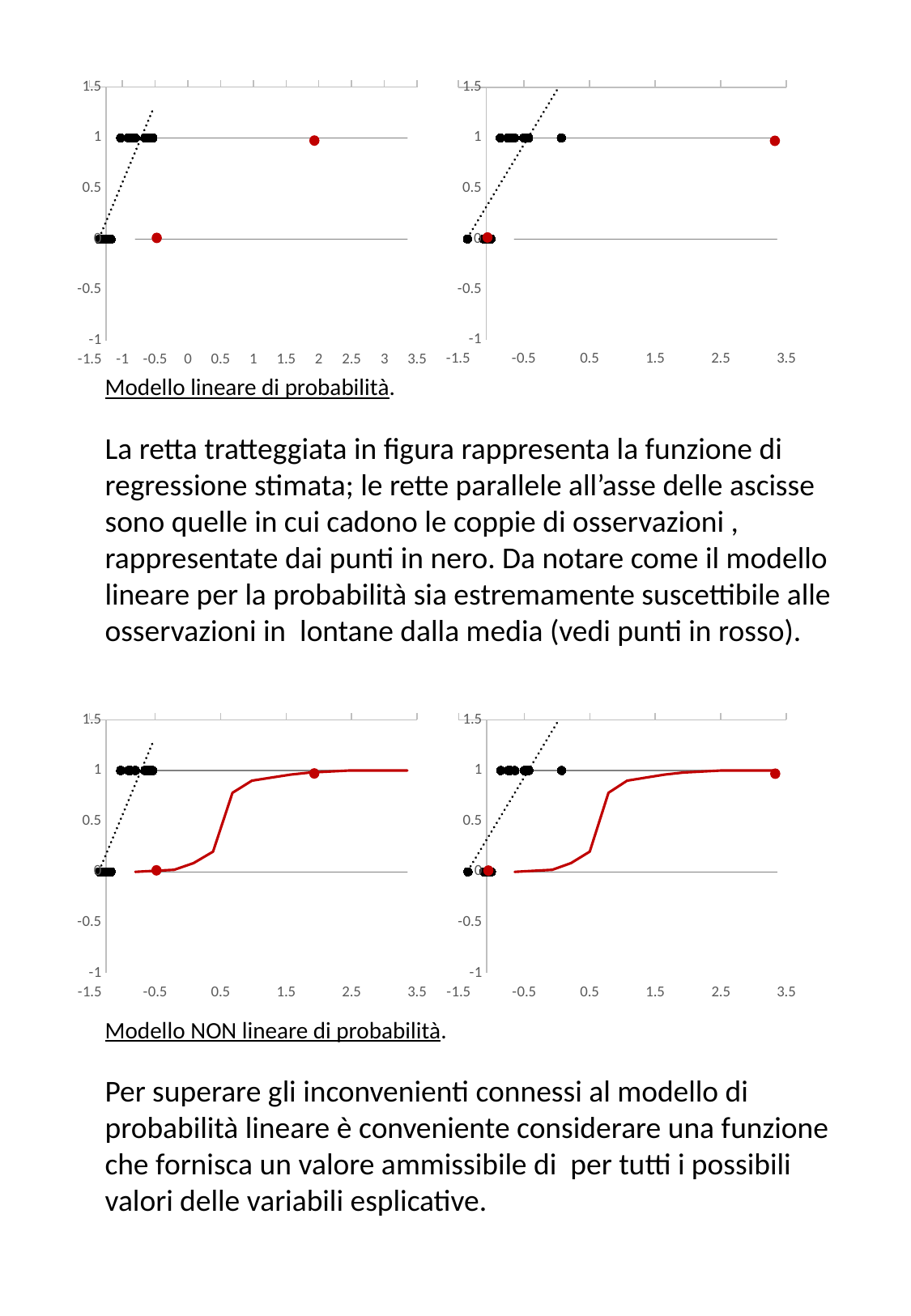
In the top-left chart, is the x value of the rightmost red point greater or less than 2.5? less In the top-left chart, is the y value of the rightmost red point greater or less than 0.5? greater In the top-left chart, is the x value of the rightmost red point greater or less than 1.5? greater In the bottom-left chart, does the red curve rise or fall as x increases? rises What is the highest tick value shown on the y axis of the top-left chart? 1.5 What is the lowest tick value shown on the x axis of the bottom-right chart? -1.5 In the bottom-right chart, does the red curve rise or fall as x increases? rises How many charts are shown on the slide? 4 What kind of chart is the top-left chart on the slide? scatter chart